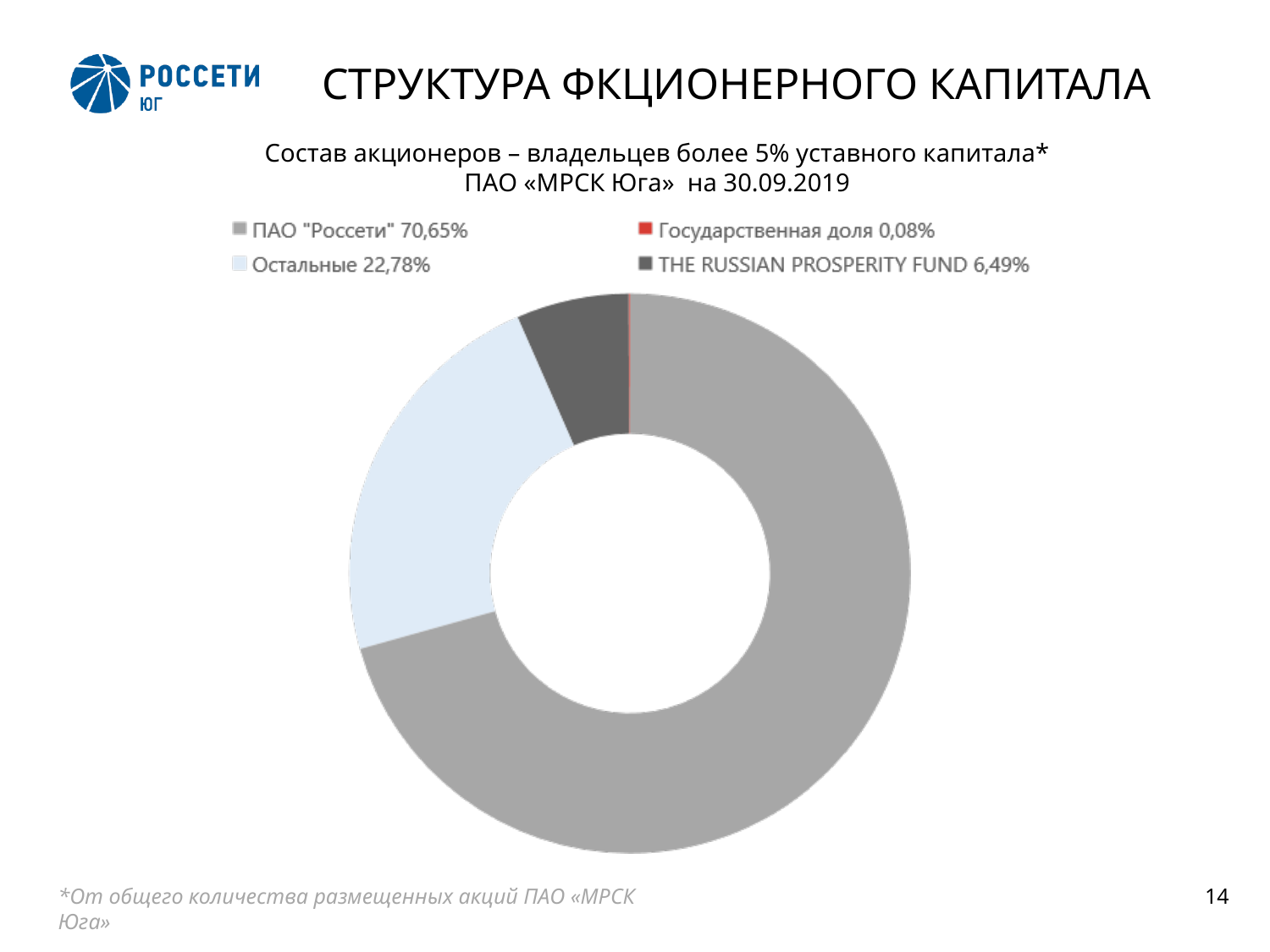
What is the difference between the shares of Остальные and THE RUSSIAN PROSPERITY FUND? 16,29% What is the difference between the shares of ПАО "Россети" and Остальные? 47,87% What is the value shown for Остальные? 22,78% As of what date does the chart show the shareholder structure of ПАО «МРСК Юга»? 30.09.2019 How many shareholder categories does the chart show? 4 Which is larger: the share of Остальные or the share of THE RUSSIAN PROSPERITY FUND? Остальные What share is shown for THE RUSSIAN PROSPERITY FUND? 6,49% Which shareholder category has the smallest share in the chart? Государственная доля What is the value shown for Государственная доля? 0,08% What share of the share capital does ПАО "Россети" hold according to the chart? 70,65% Which shareholder category has the largest share in the chart? ПАО "Россети" What type of chart is shown on the slide? Pie (doughnut) chart